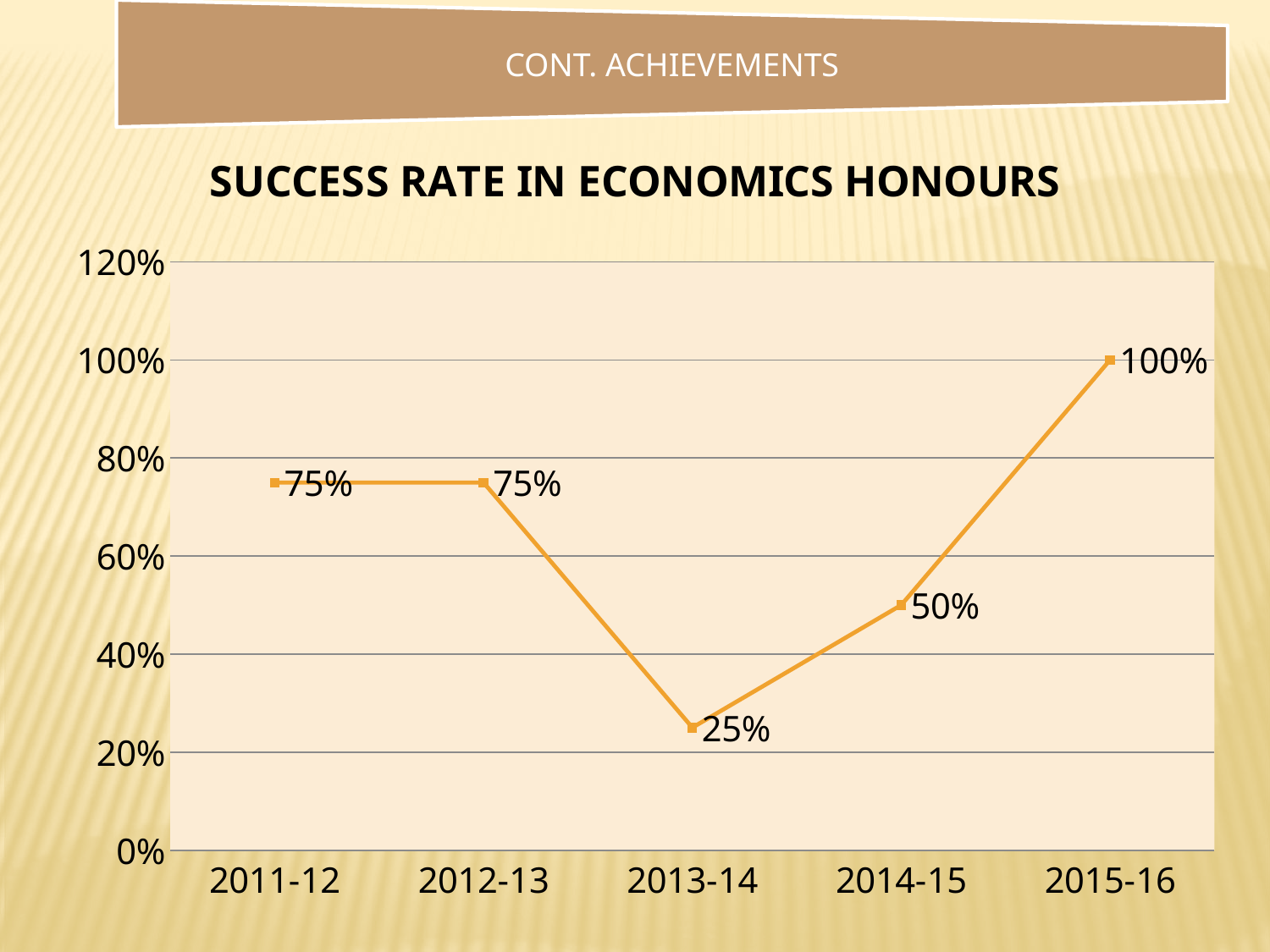
Which year has the lowest success rate in Economics Honours? 2013-14 How many years are plotted on the chart? 5 What is the success rate in Economics Honours for 2015-16? 100% Which year has a higher success rate, 2014-15 or 2011-12? 2011-12 What kind of chart is shown on the slide? Line chart What is the difference between the success rates for 2015-16 and 2013-14? 75% Is the success rate for 2014-15 greater or less than 60%? less What is the difference between the success rates for 2012-13 and 2014-15? 25% What is the success rate in Economics Honours for 2014-15? 50% What is the title of the chart? SUCCESS RATE IN ECONOMICS HONOURS Which year has the highest success rate in Economics Honours? 2015-16 What is the success rate in Economics Honours for 2013-14? 25%